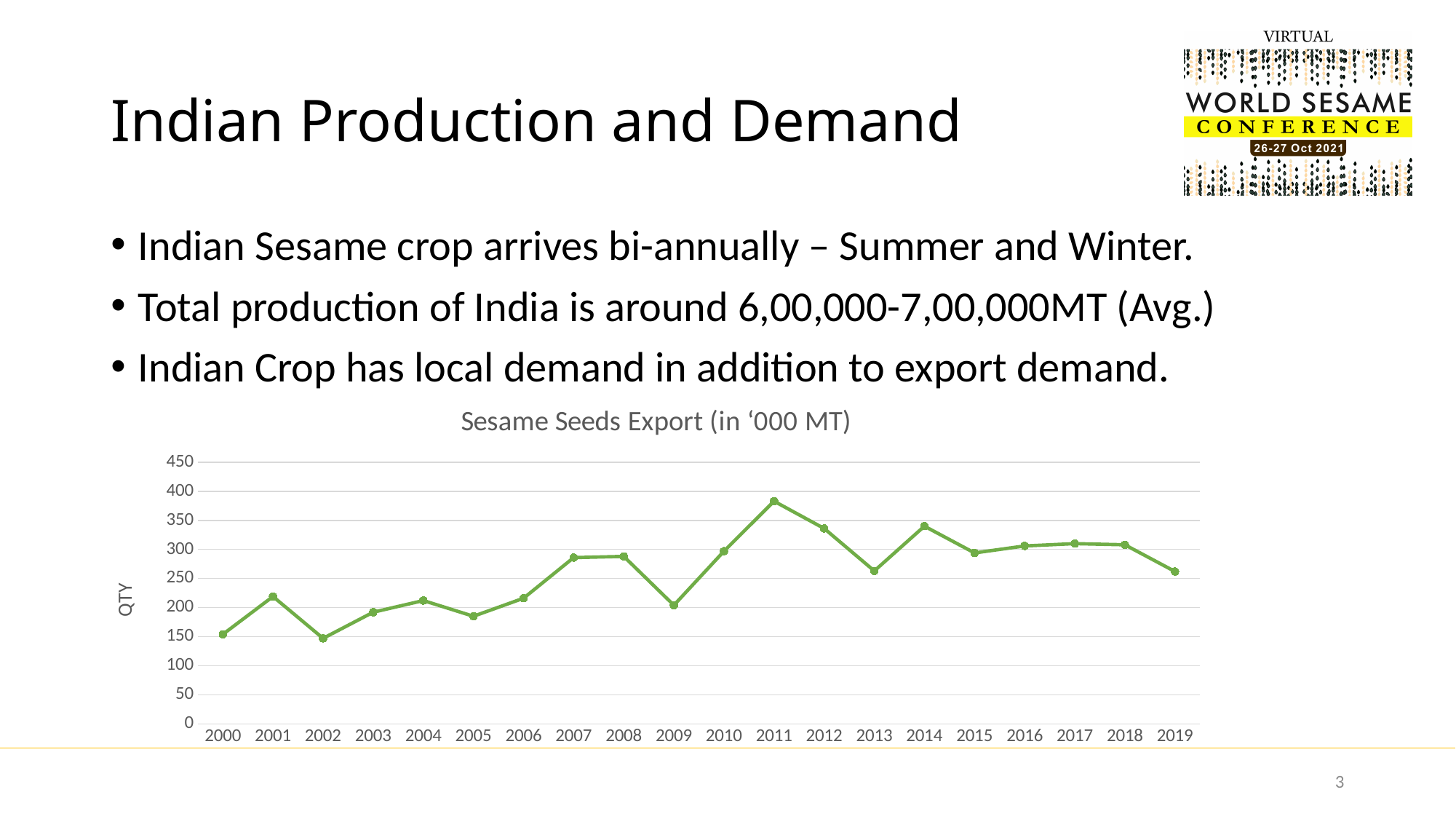
How many years are plotted on the x axis of the chart? 20 Which year has the larger export value, 2001 or 2005? 2001 Is the export value for 2007 greater or less than 300? less Is the export value for 2012 greater or less than 300? greater In which year is the sesame seeds export highest? 2011 What kind of chart is shown on the slide? line chart Does the export value rise or fall from 2011 to 2013? fall What is the label on the vertical axis of the chart? QTY Which year has the larger export value, 2011 or 2014? 2011 Is the export value for 2011 greater or less than 350? greater What is the title of the chart? Sesame Seeds Export (in '000 MT)